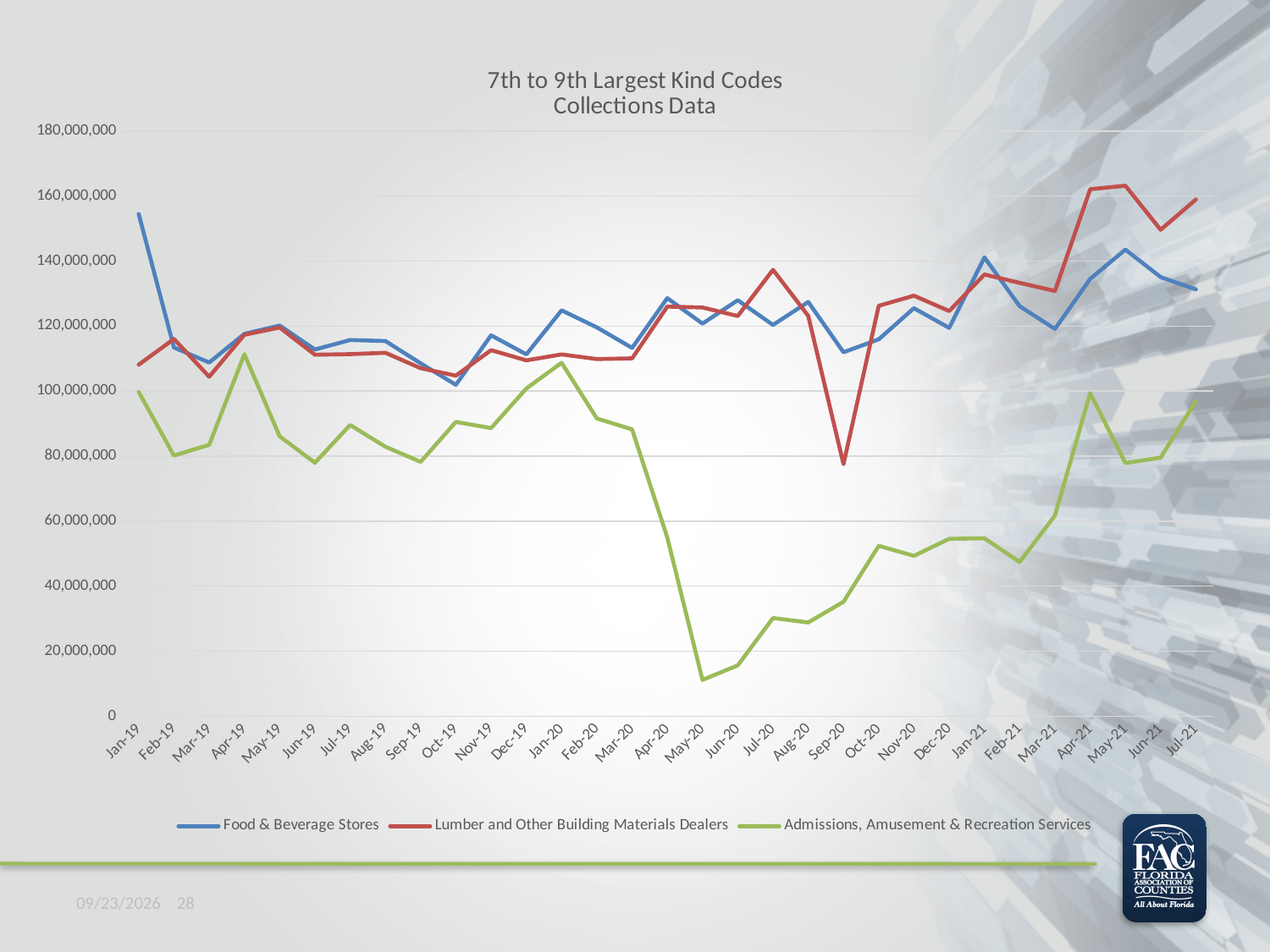
What kind of chart is shown on the slide? Line chart How many series does the legend list? 3 In Sep-20, which is larger: Food & Beverage Stores or Lumber and Other Building Materials Dealers? Food & Beverage Stores Does the value for Admissions, Amusement & Recreation Services rise or fall from Mar-20 to May-20? fall What is the title of the chart? 7th to 9th Largest Kind Codes Collections Data Which series is drawn in green? Admissions, Amusement & Recreation Services In which month is the value for Admissions, Amusement & Recreation Services lowest? May-20 Is the value for Food & Beverage Stores in Jan-19 greater or less than 140,000,000? greater Is the value for Lumber and Other Building Materials Dealers in Sep-20 greater or less than 80,000,000? less How many months are plotted along the x axis? 31 Is the value for Admissions, Amusement & Recreation Services in May-20 greater or less than 20,000,000? less In which month is the value for Food & Beverage Stores highest? Jan-19